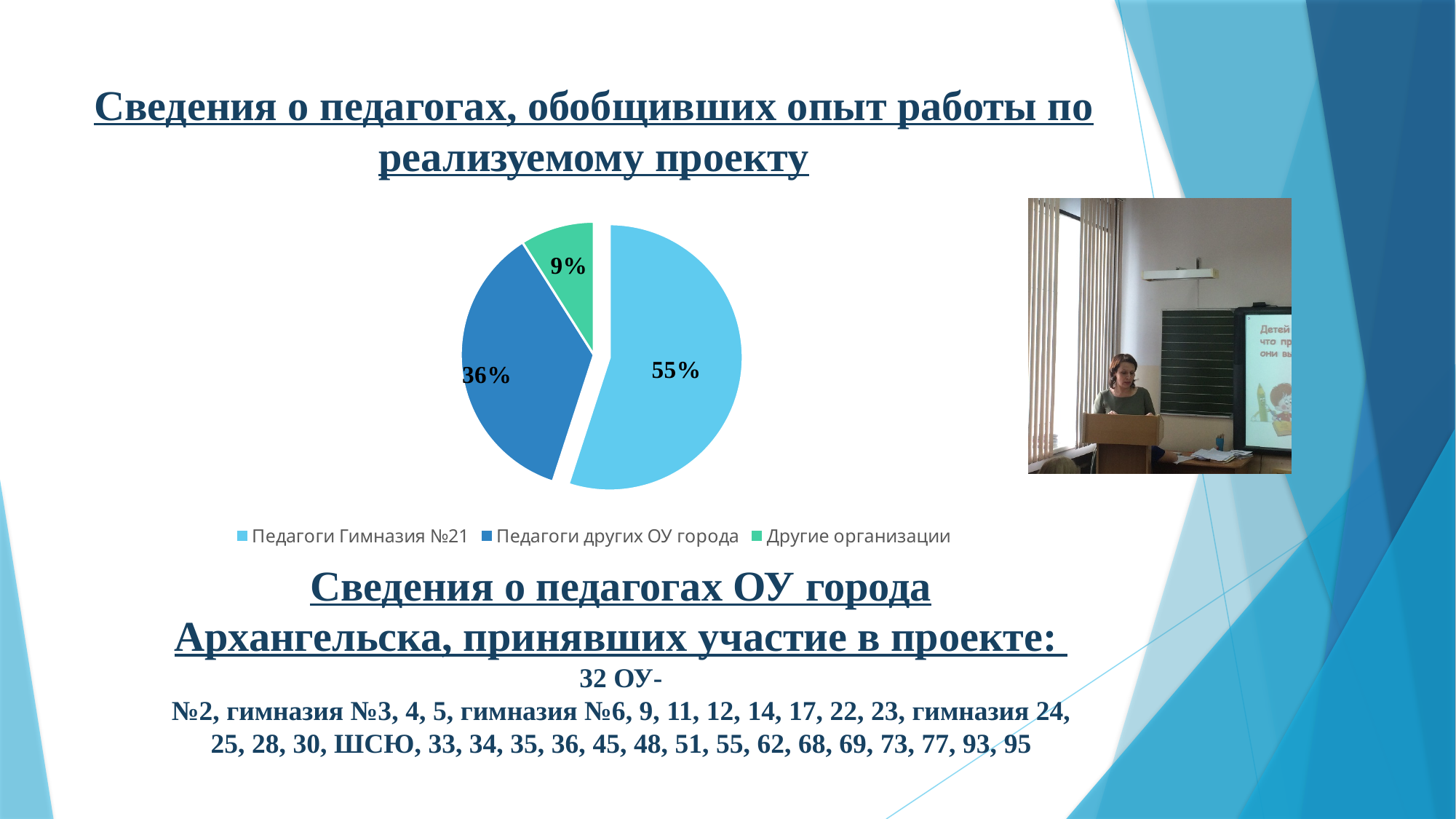
How many slices does the pie chart have? 3 Which category has the largest slice of the pie? Педагоги Гимназия №21 How many entries does the legend list? 3 What share of the pie does "Педагоги других ОУ города" have? 36% What is the difference in percentage points between "Педагоги Гимназия №21" and "Педагоги других ОУ города"? 19 What share of the pie does "Другие организации" have? 9% What kind of chart is shown on the slide? Pie chart What colour is the slice for "Другие организации"? Green What is the difference in percentage points between "Педагоги других ОУ города" and "Другие организации"? 27 What share of the pie does "Педагоги Гимназия №21" have? 55% Which category has the smallest slice of the pie? Другие организации Which is larger: the slice for "Педагоги других ОУ города" or the slice for "Другие организации"? Педагоги других ОУ города